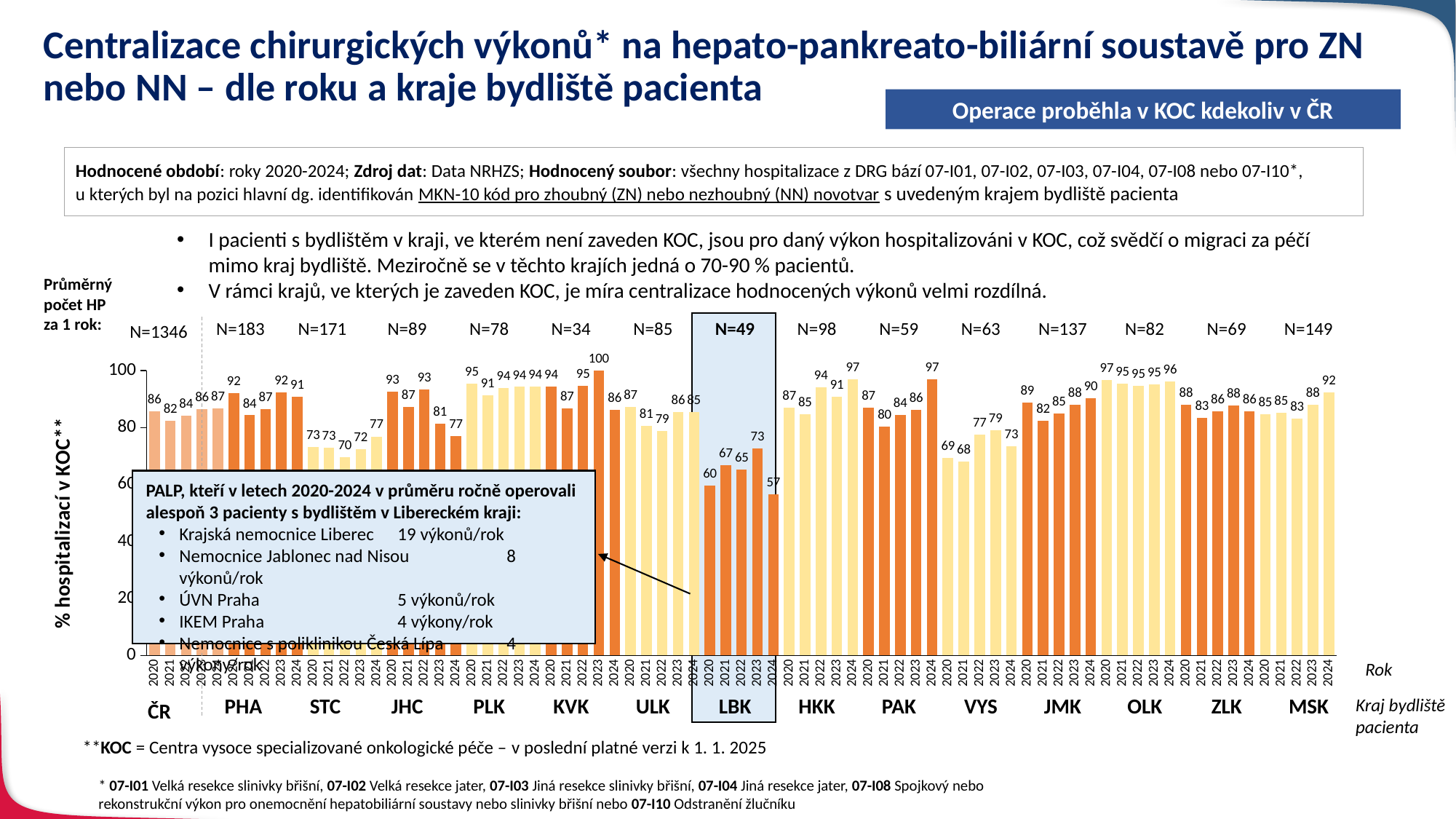
What is the value for HKK in 2024? 97 What is the value for ČR in 2020? 86 How many regions (kraje) are shown along the x axis, including ČR? 15 Which region and year has the lowest bar in the chart? LBK 2024 (57) Is the value for STC in 2022 greater or less than 80? less From 2021 to 2024, do the values for JMK rise or fall? rise What is the value for LBK in 2024? 57 What is the N value shown above the LBK group? N=49 What kind of chart is shown on the slide? bar chart Which is larger, the 2020 value for PHA or the 2020 value for STC? PHA What is the difference between the LBK values for 2023 and 2024? 16 Which region and year has the highest bar in the chart? KVK 2023 (100)